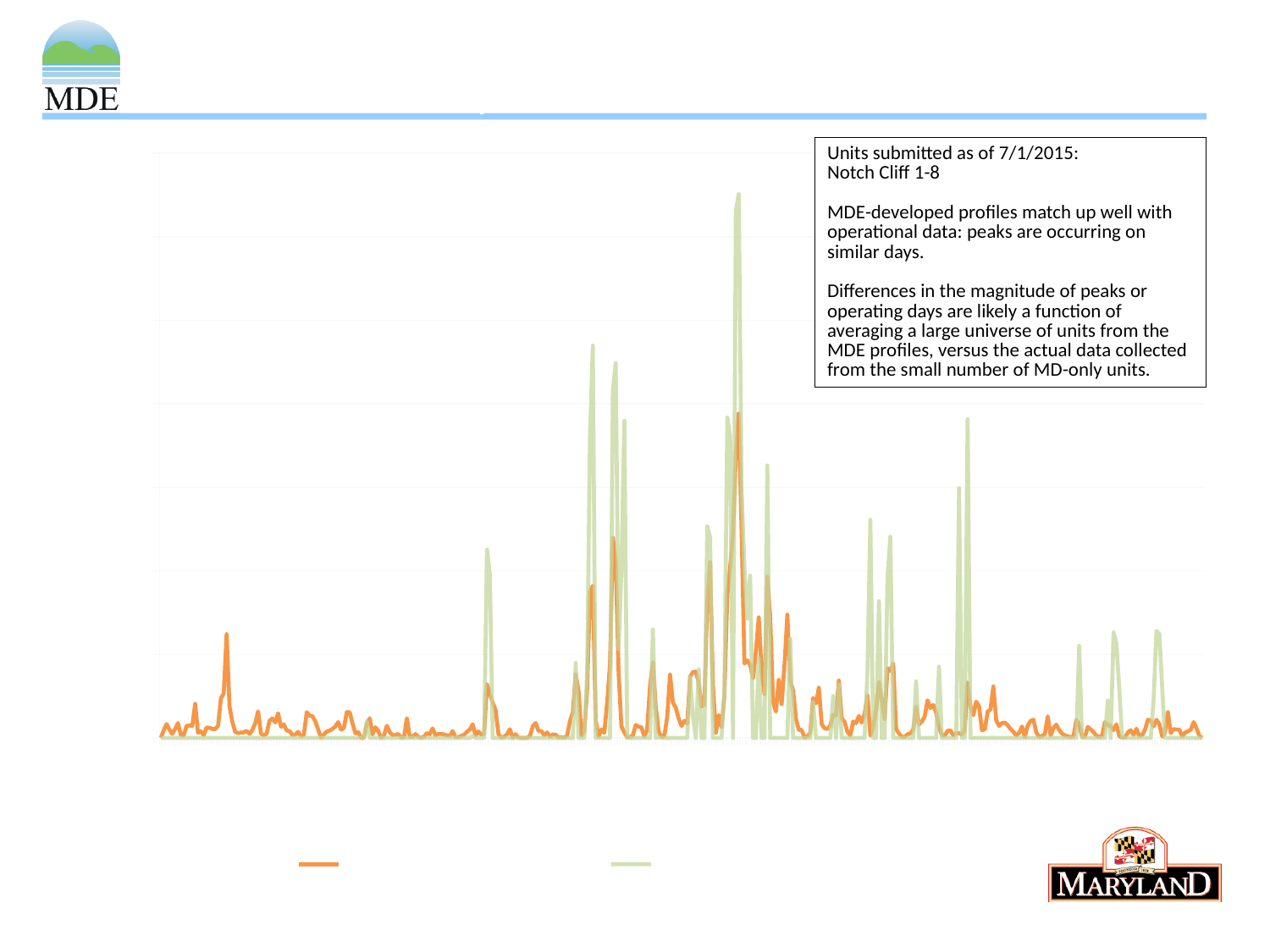
How many lines are plotted in the chart? 2 What two colours are used for the lines in the chart? orange and light green What kind of chart is shown on the slide? line chart Which line reaches the highest peak in the chart, the orange line or the green line? the green line Which units does the text box on the chart say were submitted as of 7/1/2015? Notch Cliff 1-8 How many series does the legend below the chart list? 2